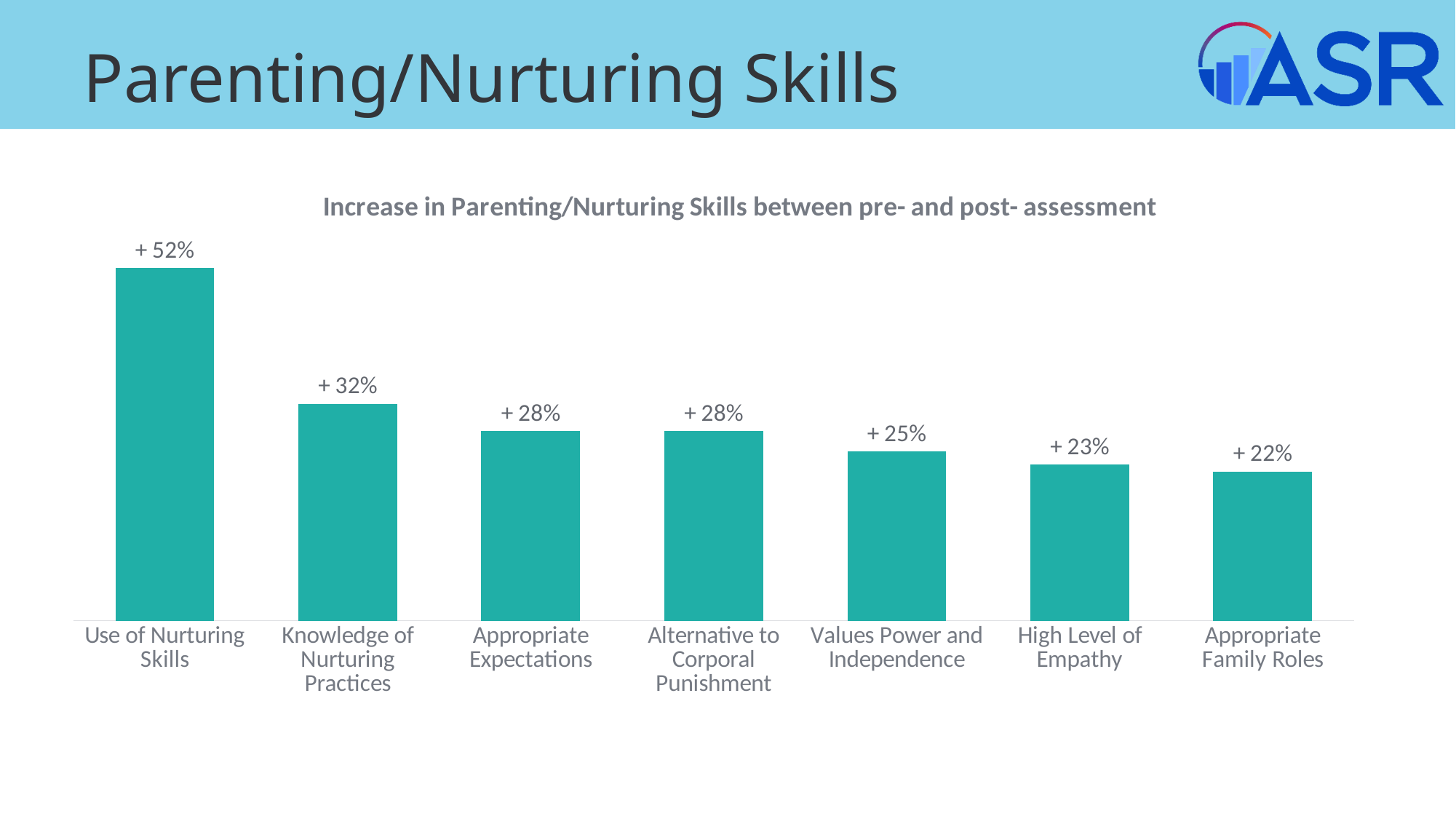
What is the difference between the values for High Level of Empathy and Appropriate Family Roles? 1% Which category has the lowest value? Appropriate Family Roles Which is larger, the value for Knowledge of Nurturing Practices or the value for Appropriate Expectations? Knowledge of Nurturing Practices How many categories are shown in the chart? 7 Which category has the highest value? Use of Nurturing Skills What is the value for Use of Nurturing Skills? + 52% What kind of chart is shown on the slide? Bar chart What is the value for Values Power and Independence? + 25% What is the value for Appropriate Family Roles? + 22% What is the title of the chart? Increase in Parenting/Nurturing Skills between pre- and post- assessment What is the difference between the values for Use of Nurturing Skills and Knowledge of Nurturing Practices? 20% What is the value for Knowledge of Nurturing Practices? + 32%